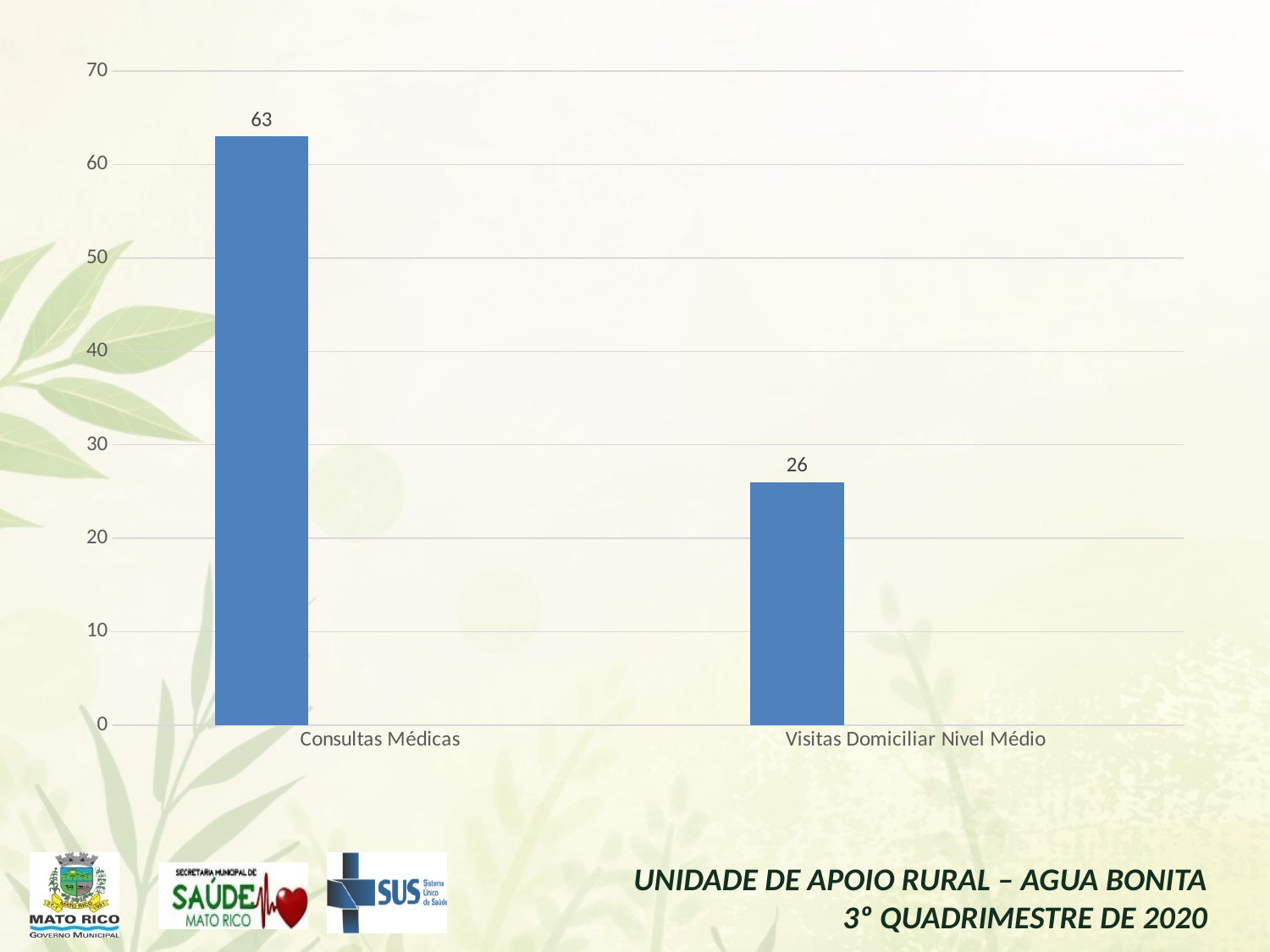
Which is larger, the value for Consultas Médicas or the value for Visitas Domiciliar Nivel Médio? Consultas Médicas How many categories are shown in the chart? 2 What kind of chart is shown on the slide? bar chart What is the highest value shown on the vertical axis? 70 What is the value for Consultas Médicas? 63 Which category has the lowest value? Visitas Domiciliar Nivel Médio What is the difference between the values for Consultas Médicas and Visitas Domiciliar Nivel Médio? 37 What colour are the bars in the chart? blue Is the value for Visitas Domiciliar Nivel Médio greater or less than 30? less Is the value for Consultas Médicas greater or less than 60? greater What is the value for Visitas Domiciliar Nivel Médio? 26 Which category has the highest value? Consultas Médicas